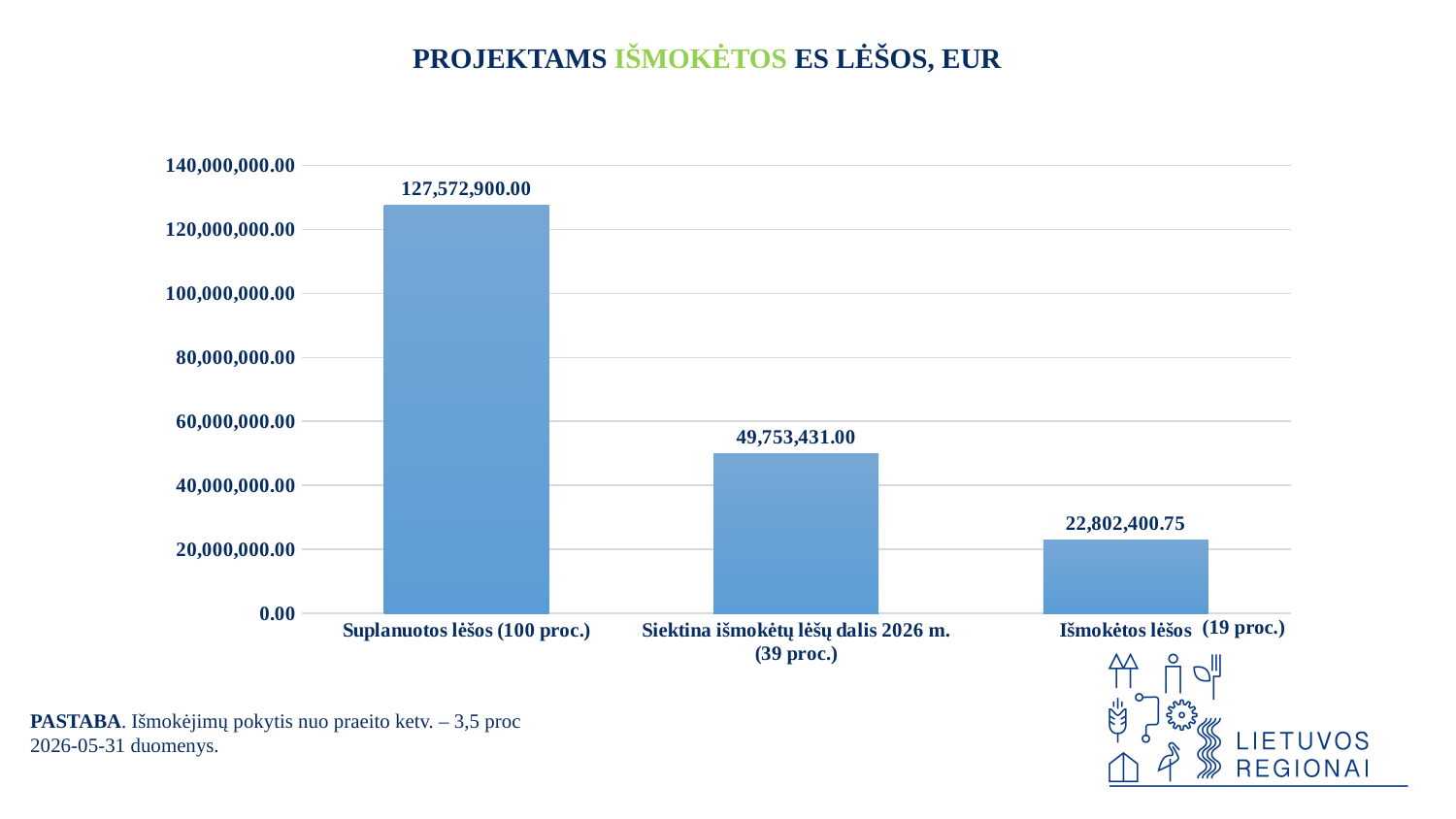
What is the value for Siektina išmokėtų lėšų dalis 2026 m. (39 proc.)? 49,753,431.00 Which category has the highest value? Suplanuotos lėšos (100 proc.) What kind of chart is shown on the slide? bar chart What is the value for Suplanuotos lėšos (100 proc.)? 127,572,900.00 What is the difference between Siektina išmokėtų lėšų dalis 2026 m. (39 proc.) and Išmokėtos lėšos (19 proc.)? 26,951,030.25 Is the value for Išmokėtos lėšos (19 proc.) greater or less than 40,000,000.00? less Which is larger, Siektina išmokėtų lėšų dalis 2026 m. (39 proc.) or Išmokėtos lėšos (19 proc.)? Siektina išmokėtų lėšų dalis 2026 m. (39 proc.) What is the difference between Suplanuotos lėšos (100 proc.) and Siektina išmokėtų lėšų dalis 2026 m. (39 proc.)? 77,819,469.00 What is the title of the chart? PROJEKTAMS IŠMOKĖTOS ES LĖŠOS, EUR Which category has the lowest value? Išmokėtos lėšos (19 proc.) How many categories are shown in the chart? 3 What is the value for Išmokėtos lėšos (19 proc.)? 22,802,400.75